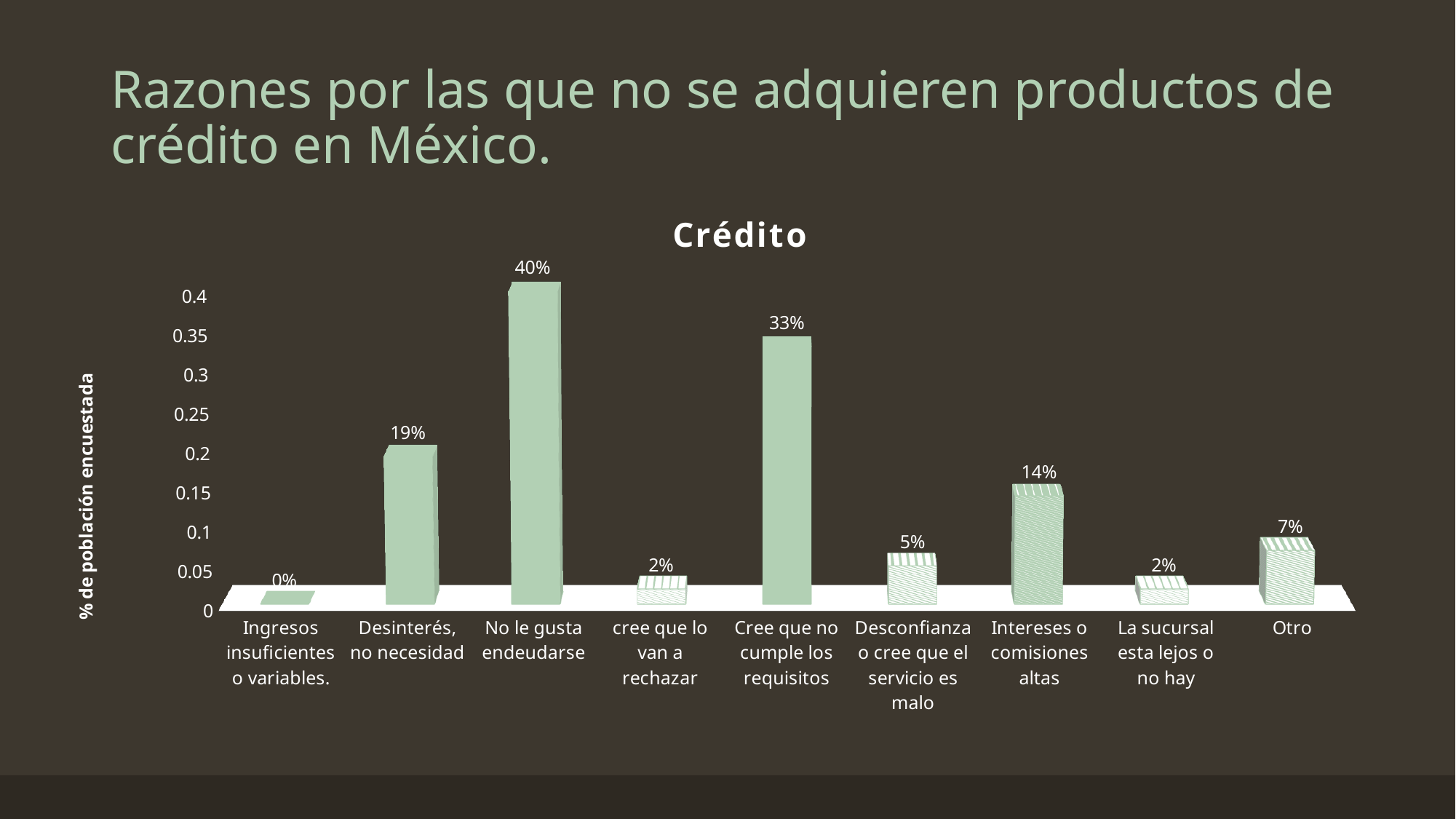
Which category has the lowest value? Ingresos insuficientes o variables. How many categories are shown on the x axis? 9 What is the label of the vertical axis? % de población encuestada Which category has the highest value? No le gusta endeudarse What is the difference between the values for "No le gusta endeudarse" and "Cree que no cumple los requisitos"? 7% What is the title of the chart? Crédito What kind of chart is shown on the slide? Bar chart What is the value for "No le gusta endeudarse"? 40% Which is larger, the value for "Desinterés, no necesidad" or the value for "Intereses o comisiones altas"? Desinterés, no necesidad What is the value for "Cree que no cumple los requisitos"? 33% What is the value for "Otro"? 7% What is the value for "Intereses o comisiones altas"? 14%